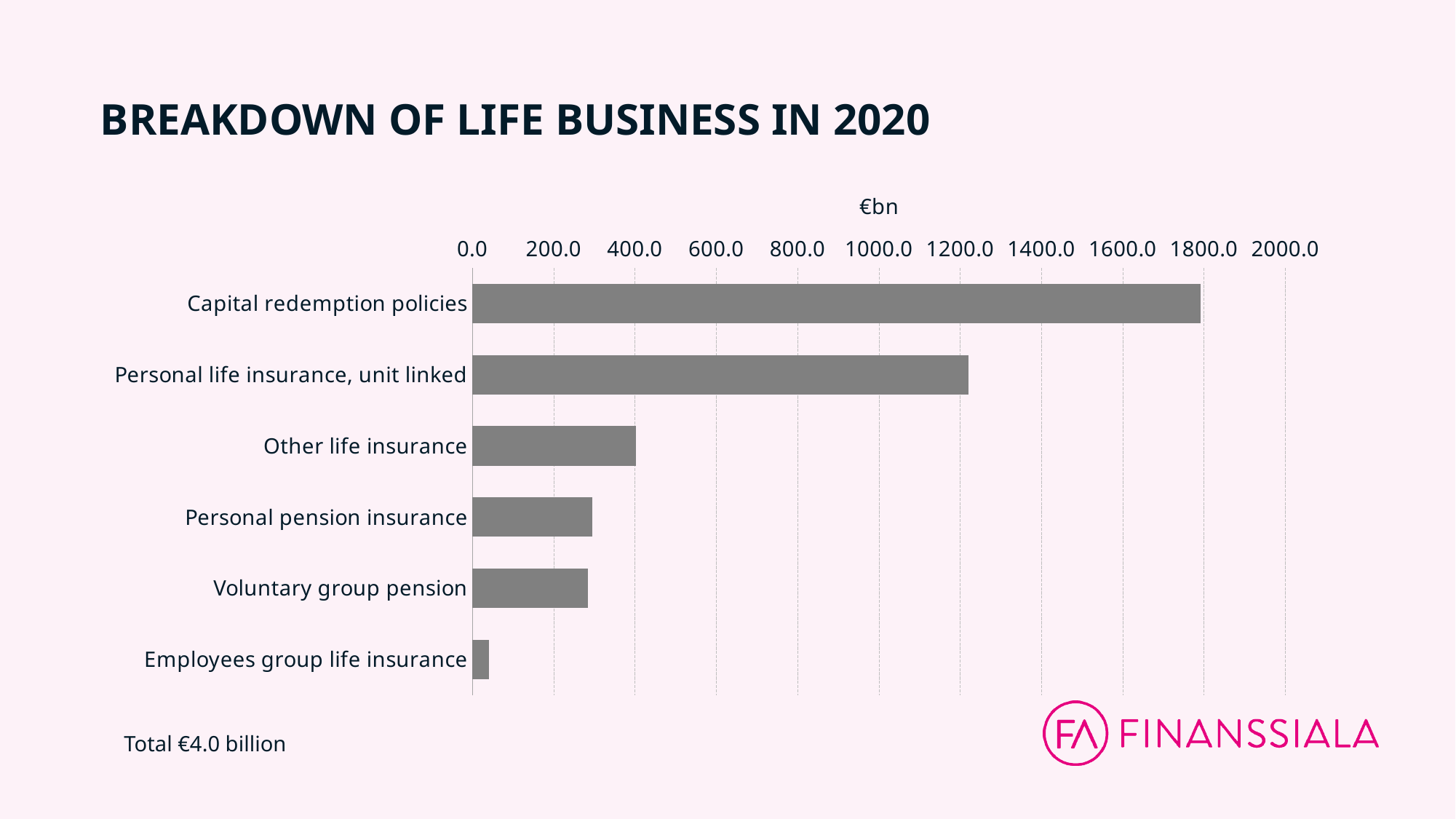
Is the value for Personal life insurance, unit linked greater or less than 1000.0? greater Which category has the highest value? Capital redemption policies Is the value for Employees group life insurance greater or less than 200.0? less Is the value for Other life insurance greater or less than 600.0? less What is the title of the chart? BREAKDOWN OF LIFE BUSINESS IN 2020 How many categories are plotted in the chart? 6 Which category has the lowest value? Employees group life insurance Which is larger, the value for Other life insurance or the value for Personal pension insurance? Other life insurance What kind of chart is shown on the slide? bar chart What unit is shown on the value axis of the chart? €bn